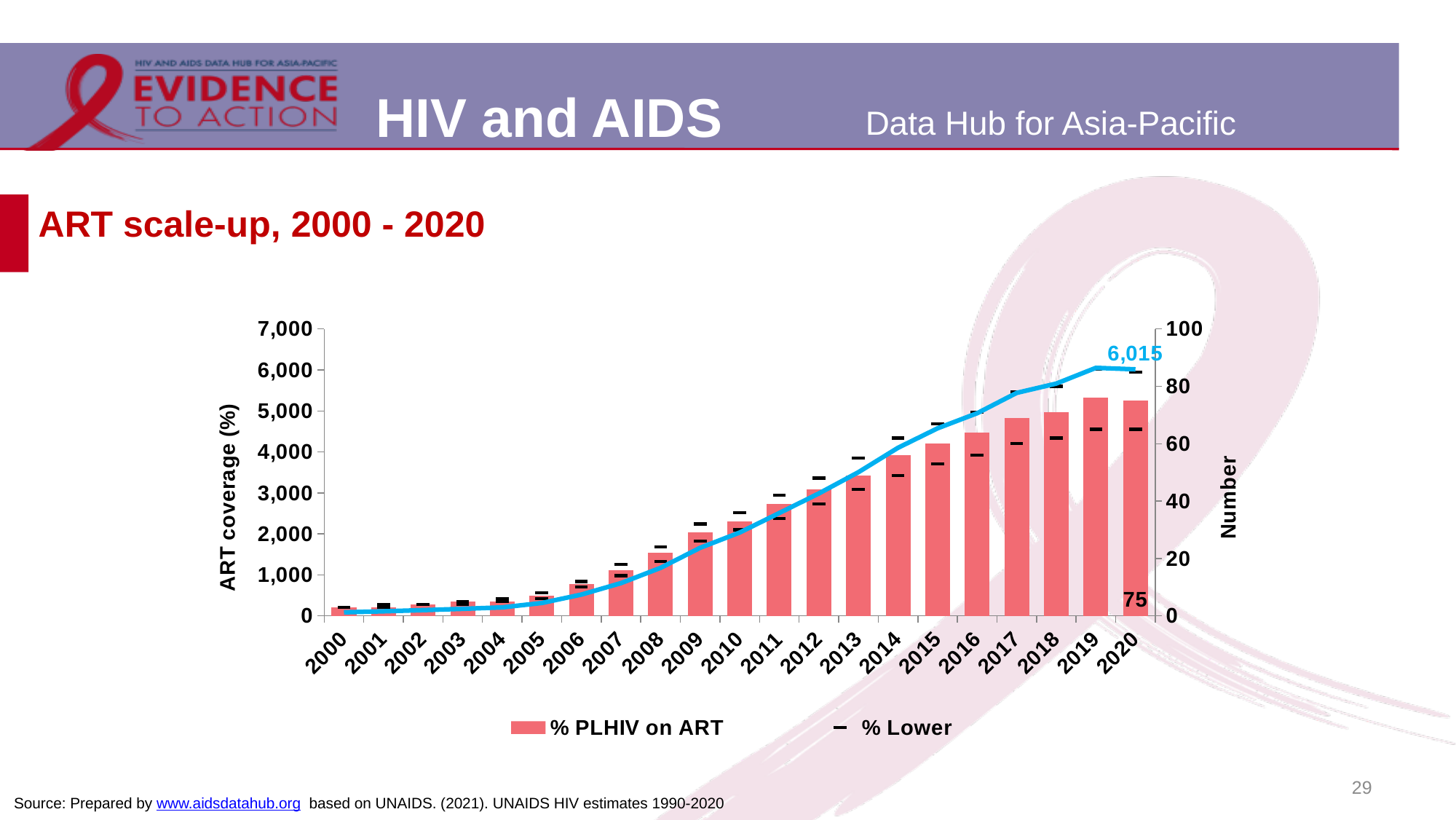
Is the bar for 2005 greater or less than 1,000 on the left axis? less How many years are shown along the x axis? 21 How many series does the legend list? 2 What value is labelled on the bar for 2020? 75 Which bar is taller, 2012 or 2014? 2014 What is the title of the chart? ART scale-up, 2000 - 2020 Is the bar for 2010 greater or less than 2,000 on the left axis? greater What is the title of the right-hand vertical axis? Number Do the bars generally rise or fall from 2000 to 2019? rise